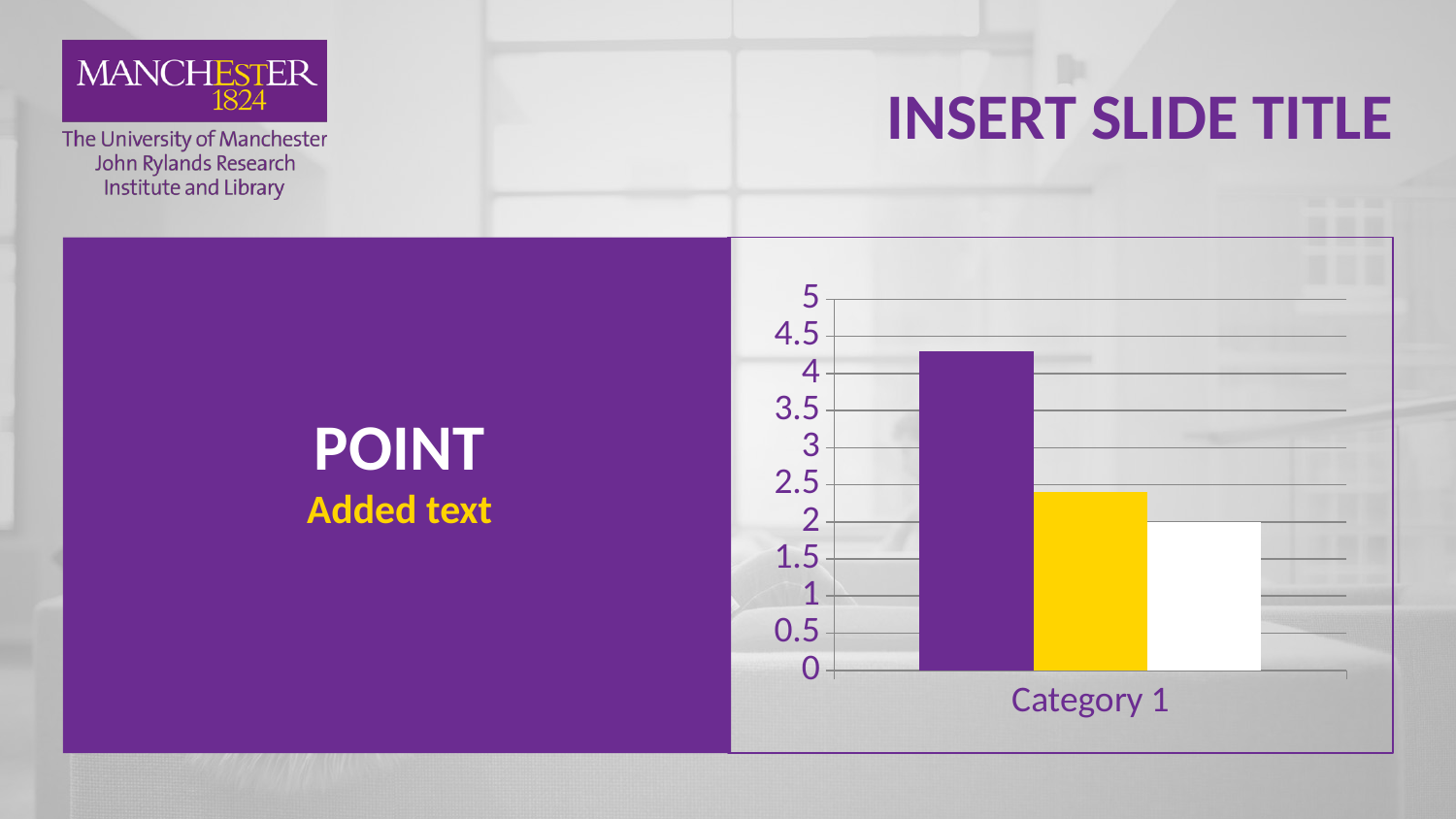
How many bars are plotted in the chart? 3 Is the value of the yellow bar greater or less than 2.5? less Is the value of the white bar greater or less than 2.5? less Is the value of the yellow bar greater or less than 2? greater How many categories are shown on the x axis of the chart? 1 What is the label of the category on the x axis of the chart? Category 1 What kind of chart is shown on the slide? bar chart Which bar is the tallest in the chart: the purple, the yellow or the white one? purple Which is larger in the chart, the purple bar or the yellow bar? purple bar Which bar is the shortest in the chart: the purple, the yellow or the white one? white